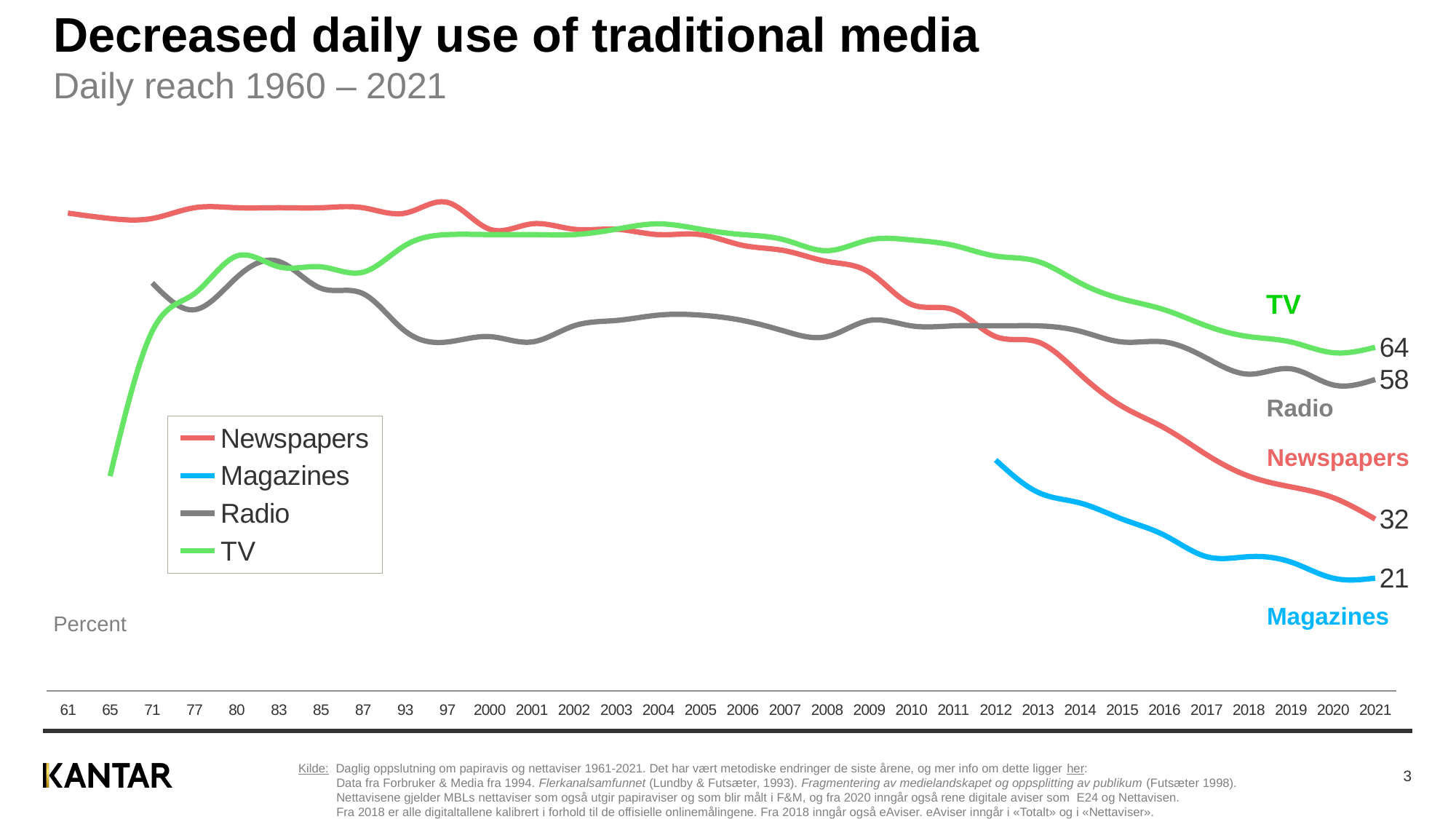
Which series has the lowest value in 2021? Magazines How many series does the legend list? 4 What is the difference between the Radio and Magazines values in 2021? 37 What is the value for TV in 2021? 64 What is the value for Newspapers in 2021? 32 In 2021, which is larger: Radio or Newspapers? Radio What is the value for Radio in 2021? 58 Does the Newspapers line rise or fall from 2012 to 2021? Fall What is the value for Magazines in 2021? 21 Which series has the highest value in 2021? TV What is the difference between the TV and Newspapers values in 2021? 32 What kind of chart is shown on the slide? Line chart